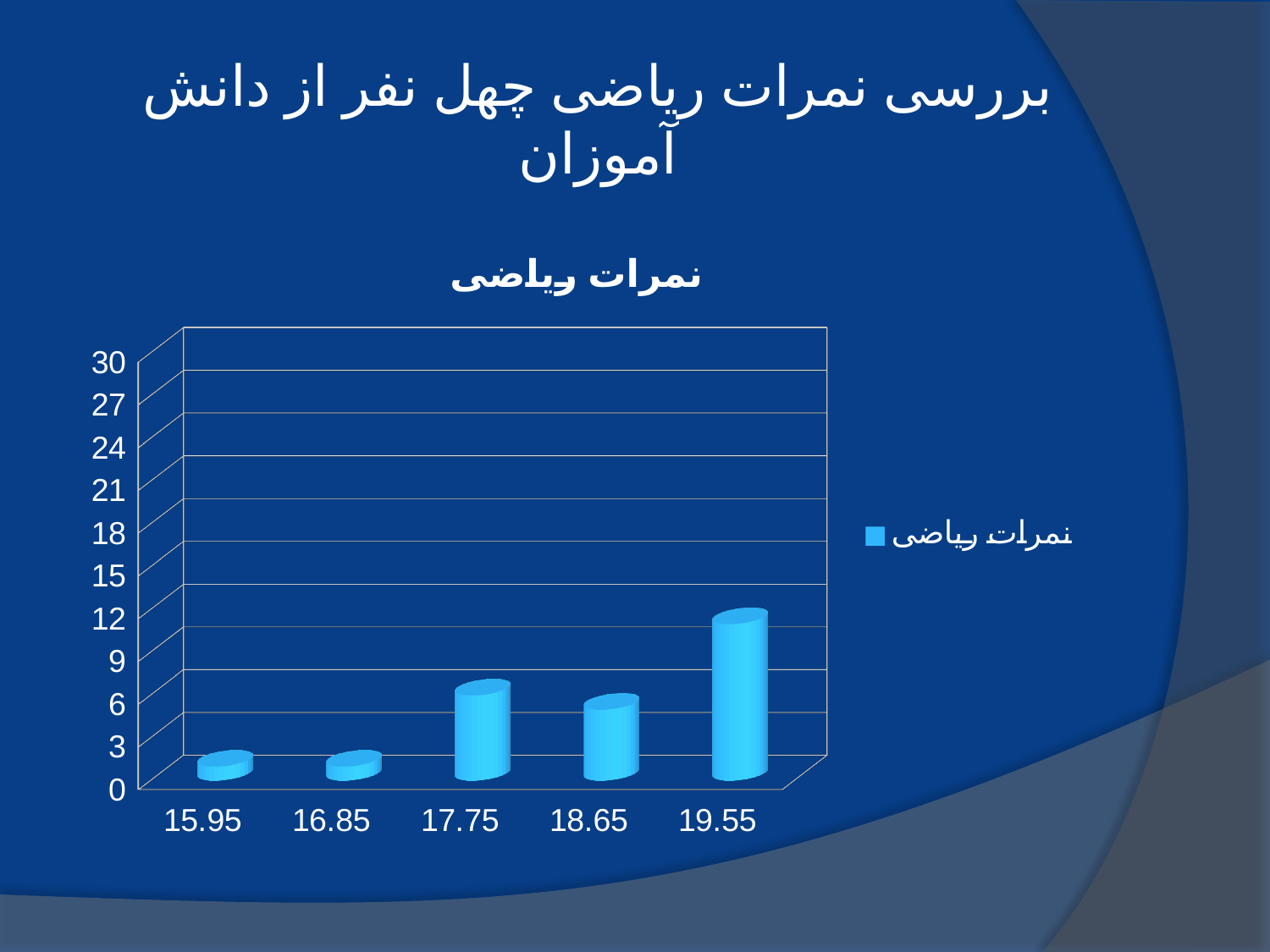
Is the value for 18.65 greater or less than 3? greater Is the value for 19.55 greater or less than 15? less Is the value for 17.75 greater or less than 9? less How many categories are shown on the x axis of the chart? 5 What is the title of the chart? نمرات ریاضی Which is larger, the value for 19.55 or the value for 18.65? 19.55 How many series does the chart's legend list? 1 Which is larger, the value for 17.75 or the value for 16.85? 17.75 What kind of chart is shown on the slide? bar chart Which category has the highest bar in the chart? 19.55